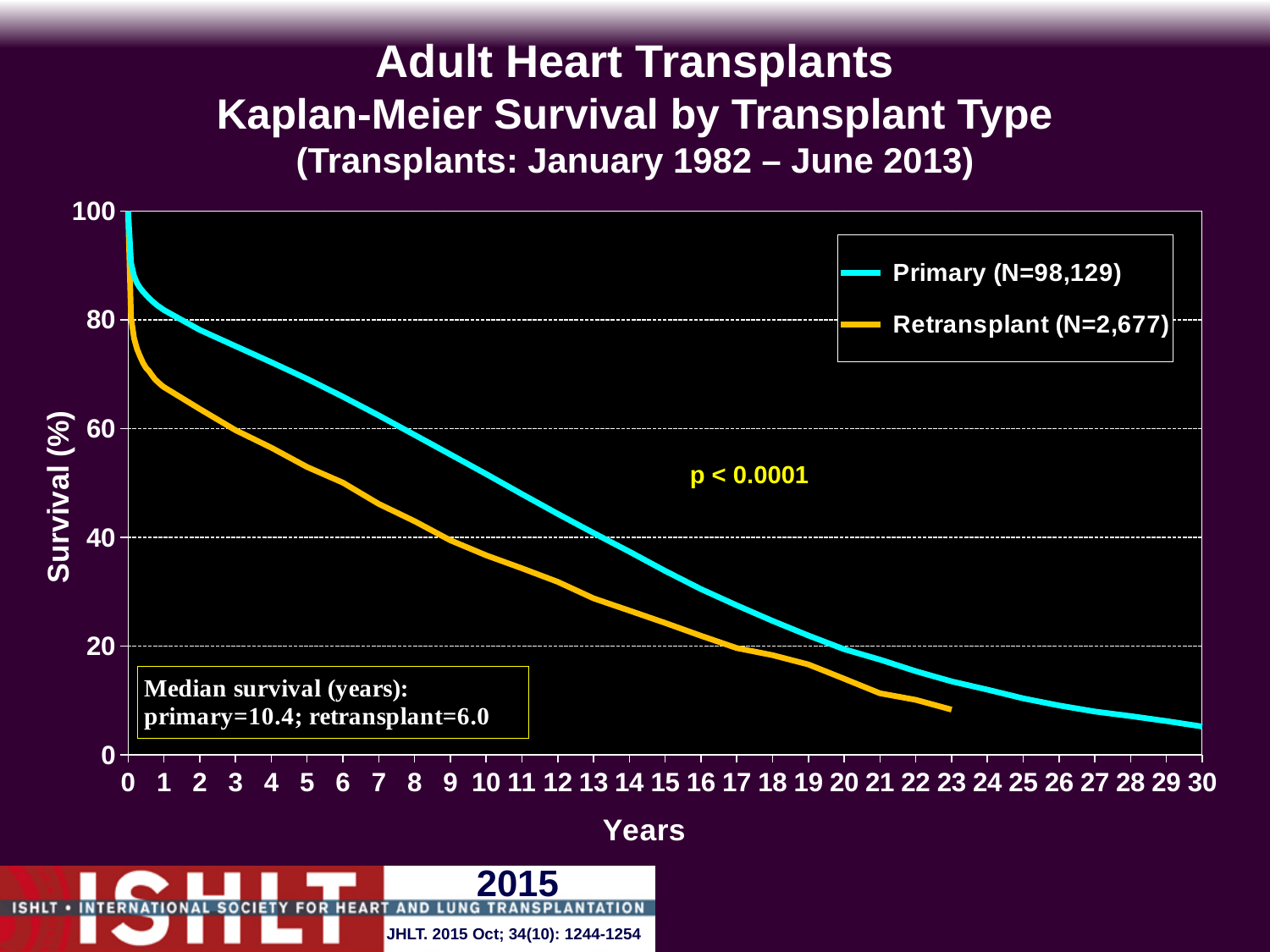
At 10 years, which series has higher survival, Primary or Retransplant? Primary What p-value is printed on the chart? p < 0.0001 What kind of chart is shown on the slide? Line chart What is the difference in median survival (years) between primary and retransplant? 4.4 What is the median survival in years for retransplants? 6.0 What is the N for the Primary series shown in the legend? 98,129 What is the median survival in years for primary transplants? 10.4 Is the survival value for Primary at 15 years greater or less than 40? less Is the survival value for Primary at 5 years greater or less than 60? greater Is the survival value for Retransplant at 10 years greater or less than 40? less How many series does the legend list? 2 Do the survival values rise or fall as years increase along the x axis? Fall